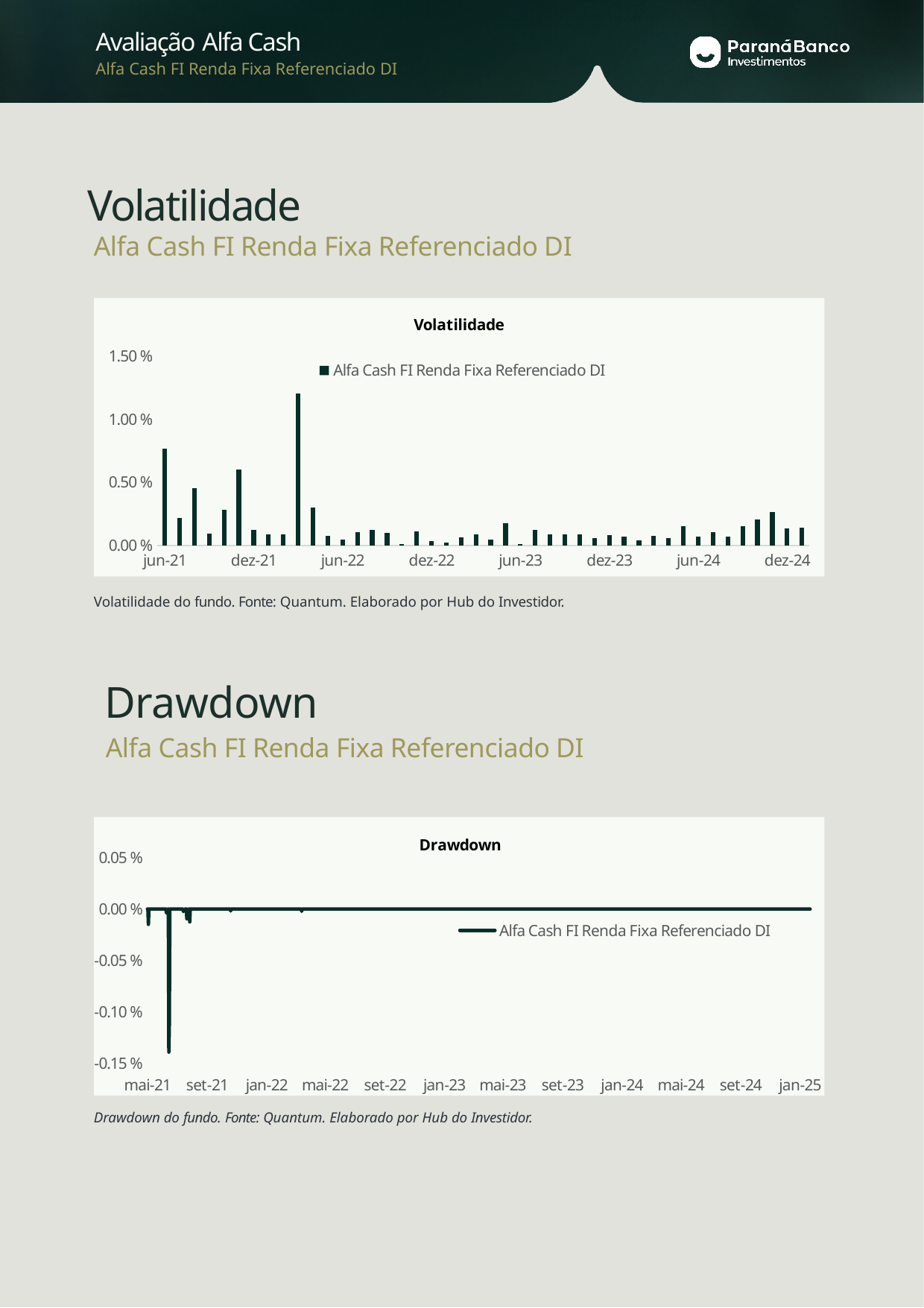
In the Volatilidade chart, is the tallest bar greater or less than 1.00 %? greater How many series does the legend of the Drawdown chart list? 1 How many date labels are shown on the x axis of the Volatilidade chart? 8 In the Volatilidade chart, is the bar at dez-24 greater or less than 0.50 %? less What kind of chart is the Volatilidade chart? bar chart In the Drawdown chart, what is the highest value shown on the vertical axis? 0.05 % In the Volatilidade chart, what is the name of the series shown in the legend? Alfa Cash FI Renda Fixa Referenciado DI How many series does the legend of the Volatilidade chart list? 1 In the Volatilidade chart, is the bar at jun-21 greater or less than 0.50 %? greater How many date labels are shown on the x axis of the Drawdown chart? 12 What kind of chart is the Drawdown chart? line chart